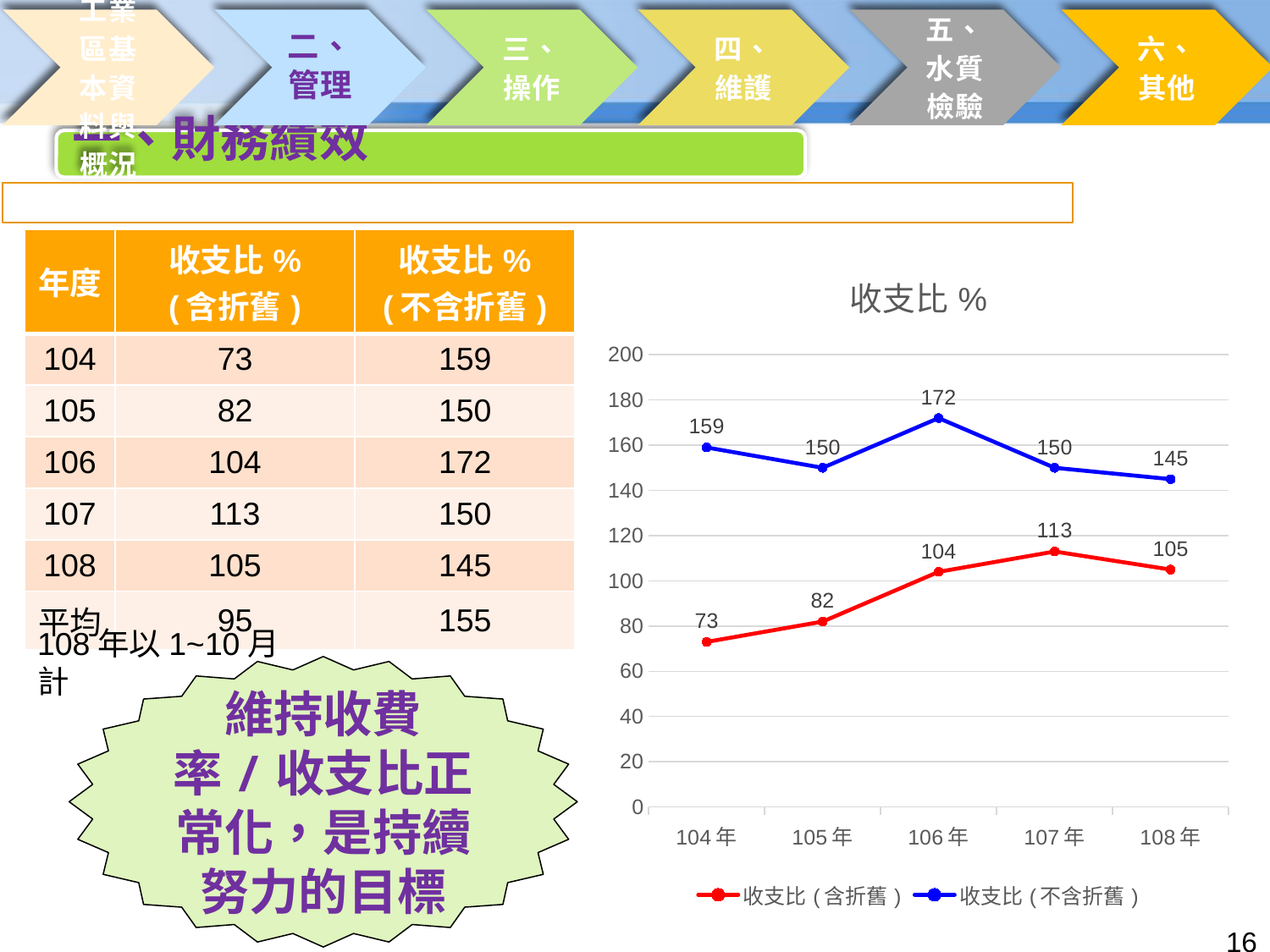
What is the value of 收支比（不含折舊） for 108年? 145 How many series does the chart legend list? 2 In which year is 收支比（含折舊） lowest? 104年 Is the value of 收支比（含折舊） for 105年 greater or less than 100? less What is the difference between 收支比（不含折舊） and 收支比（含折舊） in 104年? 86 In which year is 收支比（不含折舊） highest? 106年 How many years are shown on the x axis of the chart? 5 What kind of chart is shown on the slide? line chart What is the value of 收支比（含折舊） for 106年? 104 Does 收支比（含折舊） rise or fall from 104年 to 107年? rise Which is larger in 107年: 收支比（含折舊） or 收支比（不含折舊）? 收支比（不含折舊） What is the title of the chart? 收支比 %